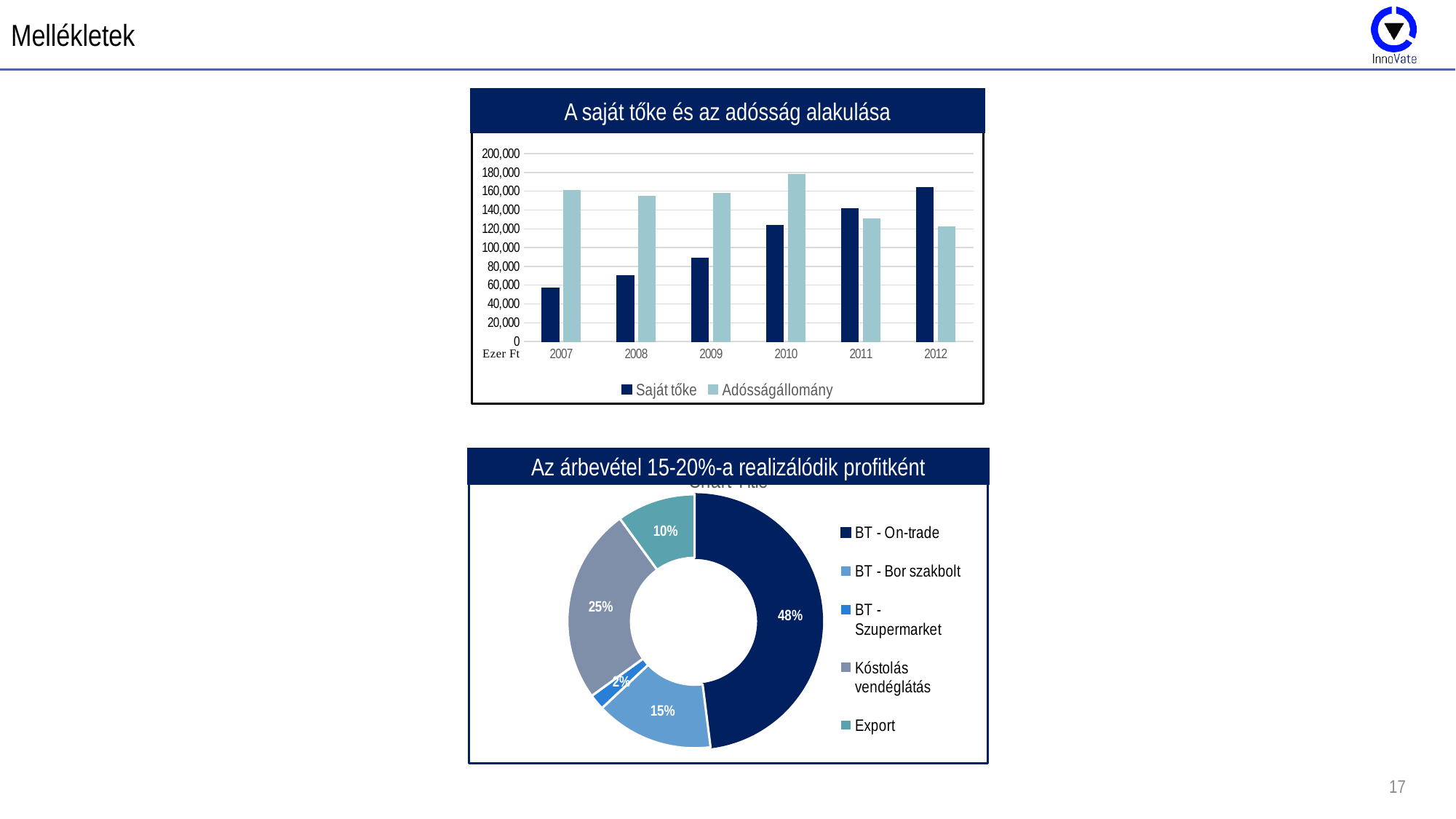
In the chart titled 'A saját tőke és az adósság alakulása', in 2012, which is larger: Saját tőke or Adósságállomány? Saját tőke In the chart titled 'A saját tőke és az adósság alakulása', in which year is Saját tőke lowest? 2007 In the chart titled 'A saját tőke és az adósság alakulása', is the value for Adósságállomány in 2010 greater or less than 160,000? greater In the chart titled 'A saját tőke és az adósság alakulása', what kind of chart is it? bar chart In the chart titled 'A saját tőke és az adósság alakulása', how many series does the legend list? 2 In the chart titled 'A saját tőke és az adósság alakulása', how many years are shown on the x axis? 6 In the chart titled 'A saját tőke és az adósság alakulása', does Saját tőke rise or fall from 2007 to 2012? rise In the chart titled 'Az árbevétel 15-20%-a realizálódik profitként', what share does BT - On-trade have? 48% In the chart titled 'A saját tőke és az adósság alakulása', in which year is Adósságállomány highest? 2010 In the chart titled 'Az árbevétel 15-20%-a realizálódik profitként', what is the difference between the shares of Kóstolás vendéglátás and Export? 15% In the chart titled 'A saját tőke és az adósság alakulása', in which year is Saját tőke highest? 2012 In the chart titled 'Az árbevétel 15-20%-a realizálódik profitként', which category has the smallest share? BT - Szupermarket